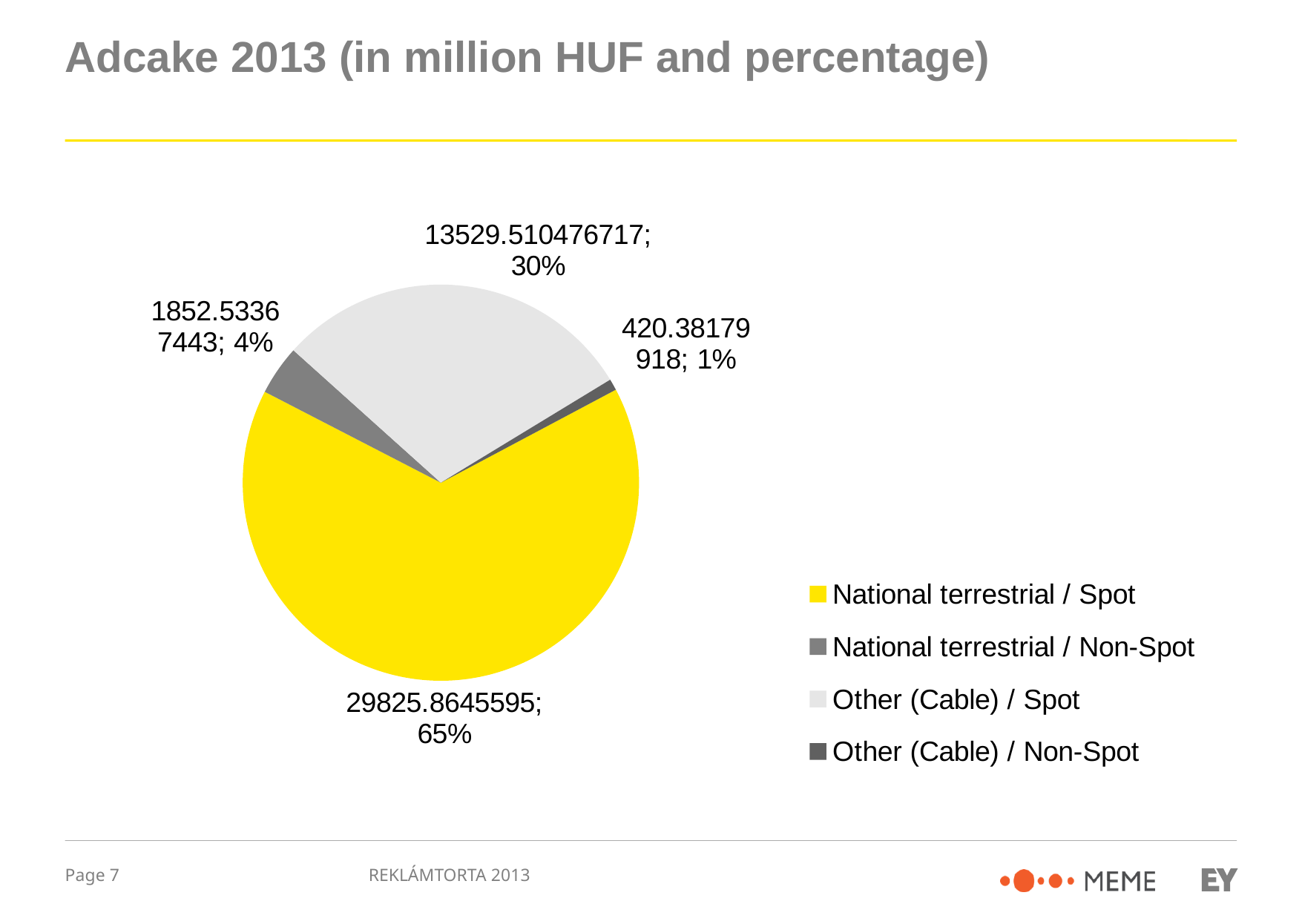
How many slices does the pie chart have? 4 What kind of chart is shown on the slide? pie chart Which category has the largest slice of the pie? National terrestrial / Spot What is the title of the chart? Adcake 2013 (in million HUF and percentage) What is the value in million HUF for National terrestrial / Spot? 29825.8645595 How many entries does the legend list? 4 What percentage share does National terrestrial / Non-Spot have? 4% What is the value in million HUF for Other (Cable) / Spot? 13529.510476717 What percentage share does National terrestrial / Spot have? 65% What percentage share does Other (Cable) / Spot have? 30% Which category has the smallest slice of the pie? Other (Cable) / Non-Spot